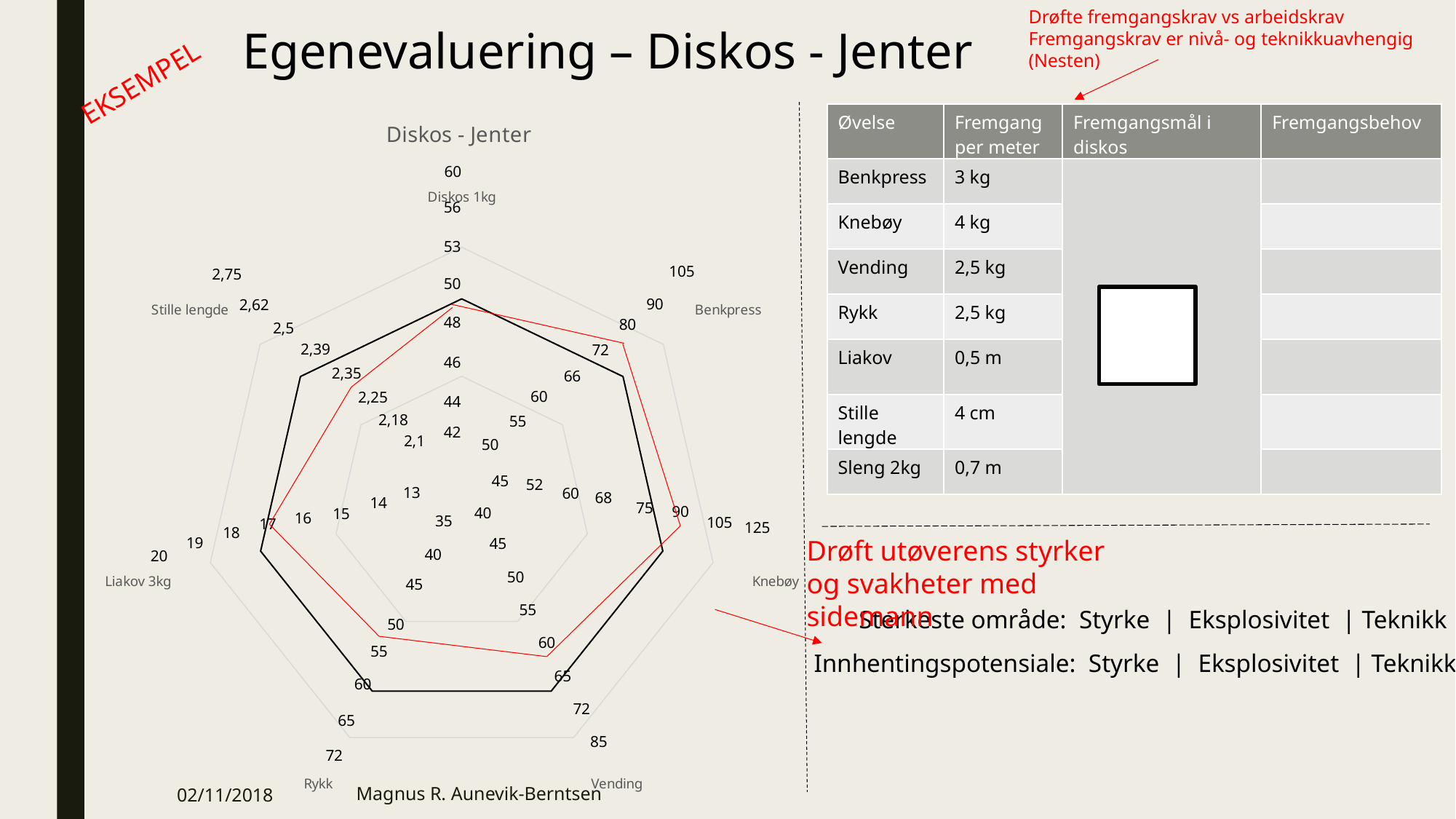
For Knebøy, which line has the larger value, the black line or the red line? red line Is the red line's value for Diskos 1kg greater or less than 53? less Which category label sits at the top of the radar chart? Diskos 1kg Is the black line's value for Benkpress greater or less than 66? greater Is the black line's value for Vending greater or less than 72? less For Benkpress, which line has the larger value, the black line or the red line? red line What kind of chart is shown on the slide? radar chart What is the title of the chart? Diskos - Jenter How many categories (axes) does the radar chart have? 7 For Stille lengde, which line has the larger value, the black line or the red line? black line